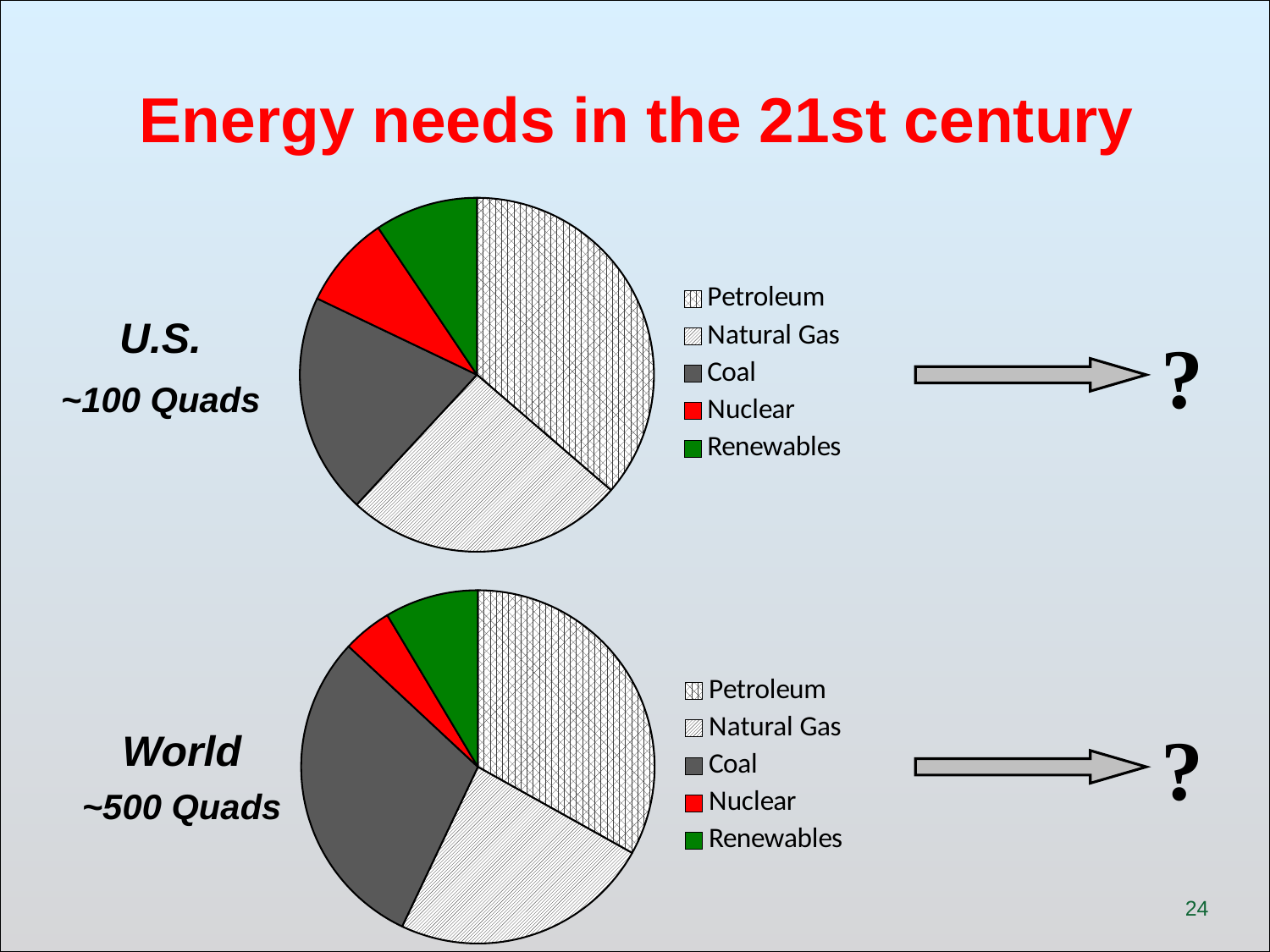
In the World pie chart, which slice is larger, Natural Gas or Nuclear? Natural Gas In the U.S. pie chart, how many energy sources does the legend list? 5 In the U.S. pie chart, which slice is larger, Petroleum or Coal? Petroleum What approximate total energy amount is labelled next to the World pie chart? ~500 Quads In the World pie chart, what colour represents Nuclear in the legend? Red In the World pie chart, which energy source has the smallest slice? Nuclear In the U.S. pie chart, which energy source has the largest slice? Petroleum In the World pie chart, which energy source has the largest slice? Petroleum In the World pie chart, how many slices are there? 5 What kind of chart is used for the World energy breakdown on the slide? Pie chart In the U.S. pie chart, which slice is larger, Coal or Renewables? Coal What kind of chart is used for the U.S. energy breakdown on the slide? Pie chart